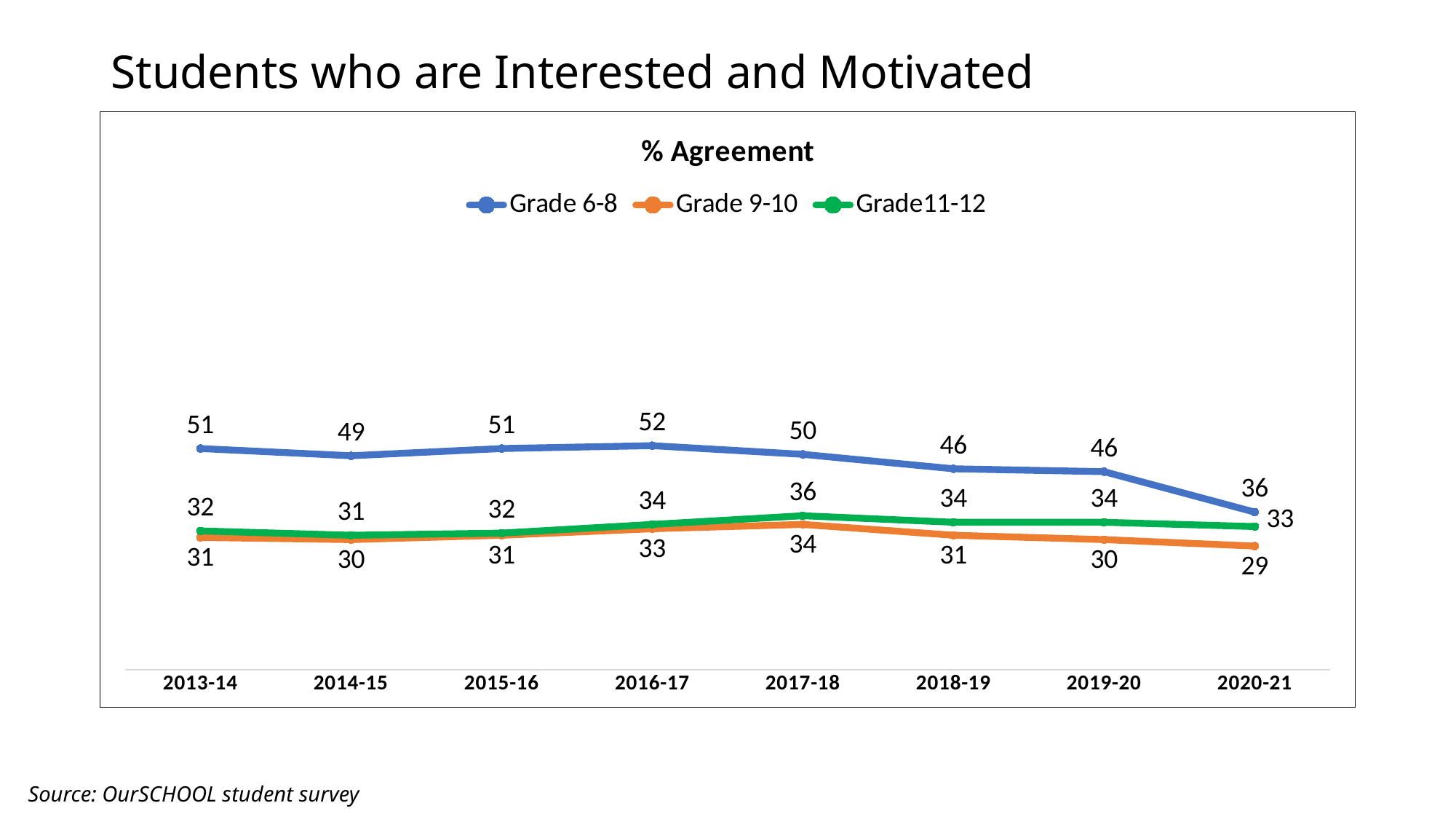
What is the difference between the Grade 6-8 value and the Grade 9-10 value in 2013-14? 20 In which year is the Grade 6-8 value highest? 2016-17 By how much did the Grade 6-8 value fall from 2019-20 to 2020-21? 10 In which year is the Grade 6-8 value lowest? 2020-21 How many series does the legend list? 3 What is the value for Grade 9-10 in 2020-21? 29 What is the value for Grade 6-8 in 2016-17? 52 What kind of chart is shown on the slide? Line chart How many years are shown on the x axis? 8 Which is larger in 2020-21, the Grade 6-8 value or the Grade11-12 value? Grade 6-8 What is the value for Grade11-12 in 2017-18? 36 What is the title of the chart? % Agreement